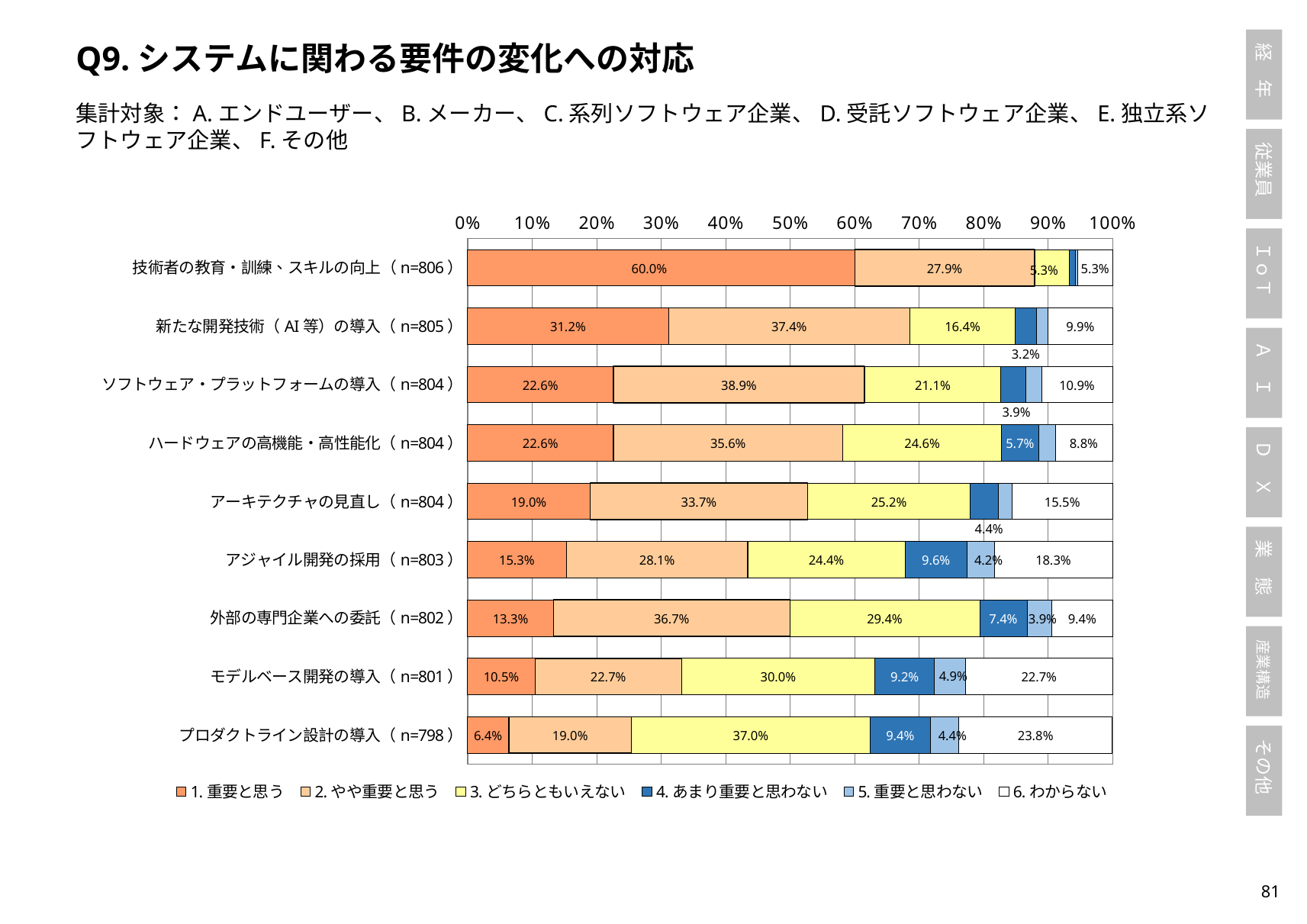
What is the value of "4. あまり重要と思わない" for アジャイル開発の採用? 9.6% What kind of chart is shown on the slide? stacked bar chart How many series does the legend list? 6 Which category has the highest value for "1. 重要と思う"? 技術者の教育・訓練、スキルの向上 What is the difference between the "3. どちらともいえない" values for プロダクトライン設計の導入 and モデルベース開発の導入? 7.0% How many categories (items) are plotted in the chart? 9 What is the value of "1. 重要と思う" for 技術者の教育・訓練、スキルの向上? 60.0% Which category has the lowest value for "1. 重要と思う"? プロダクトライン設計の導入 What is the value of "6. わからない" for プロダクトライン設計の導入? 23.8% Which is larger: the "2. やや重要と思う" value for 新たな開発技術（AI等）の導入 or for ハードウェアの高機能・高性能化? 新たな開発技術（AI等）の導入 What is the sample size (n) shown for アーキテクチャの見直し? n=804 What is the value of "2. やや重要と思う" for ソフトウェア・プラットフォームの導入? 38.9%